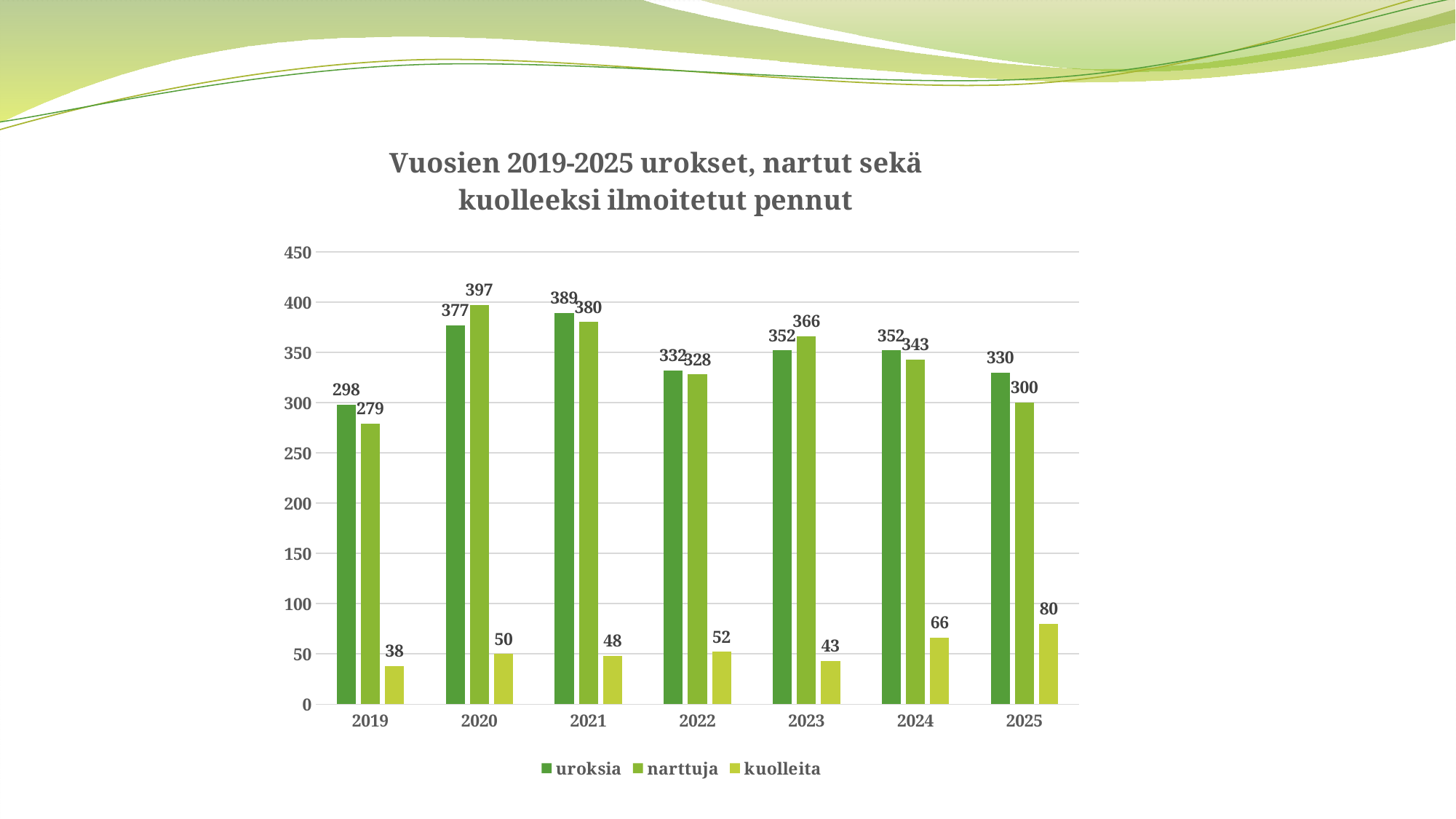
What is the difference between uroksia and narttuja in 2025? 30 How many years are shown on the x axis? 7 What is the value for uroksia in 2021? 389 Which year has the lowest value for uroksia? 2019 What is the value for narttuja in 2020? 397 What kind of chart is shown on the slide? bar chart What is the value for kuolleita in 2024? 66 Does the value for uroksia rise or fall from 2021 to 2025? fall How many series does the legend list? 3 What is the title of the chart? Vuosien 2019-2025 urokset, nartut sekä kuolleeksi ilmoitetut pennut Which year has the highest value for kuolleita? 2025 Which is larger in 2023, uroksia or narttuja? narttuja